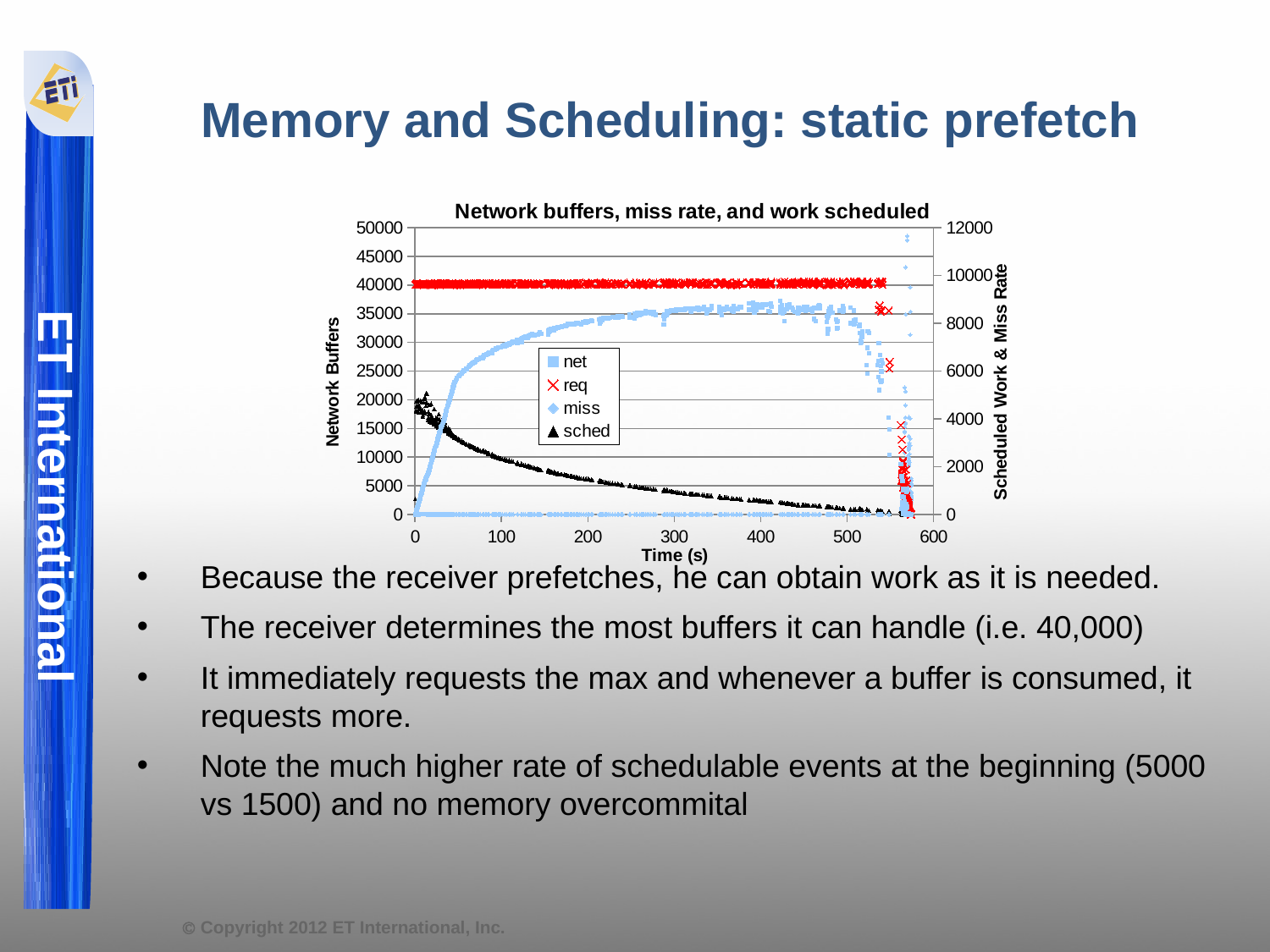
What is the label of the right vertical axis of the chart? Scheduled Work & Miss Rate What is the label of the x axis of the chart? Time (s) What is the maximum value shown on the right vertical axis? 12000 What are the four series named in the chart legend? net, req, miss, sched Does the net series rise or fall as time increases from 0 to 300 s? rise What is the title of the chart? Network buffers, miss rate, and work scheduled What is the label of the left vertical axis of the chart? Network Buffers Is the value of the req series on the left axis greater or less than 30000 for most of the run? greater How many series does the chart legend list? 4 What is the maximum value shown on the left vertical axis? 50000 What kind of chart is shown on the slide? scatter chart Does the sched series rise or fall as time increases from 0 to 500 s? fall